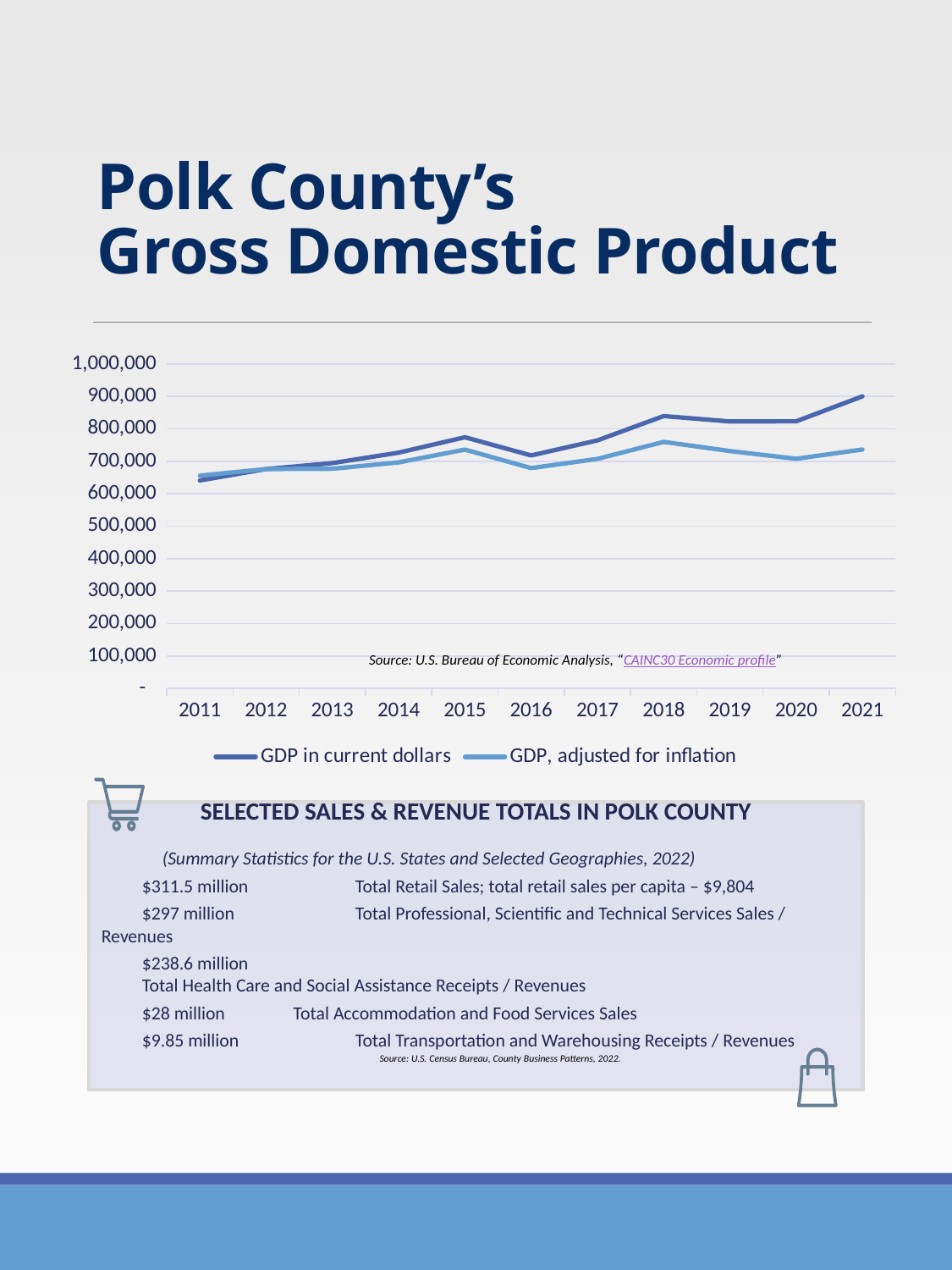
Is the value for GDP, adjusted for inflation in 2020 greater or less than 800,000? less Which year has the lowest value for GDP in current dollars? 2011 Which year has the highest value for GDP, adjusted for inflation? 2018 In 2021, which series has the larger value: GDP in current dollars or GDP, adjusted for inflation? GDP in current dollars Is the value for GDP in current dollars in 2011 greater or less than 700,000? less Which year has the highest value for GDP in current dollars? 2021 Is the value for GDP in current dollars in 2021 greater or less than 800,000? greater Overall, does GDP in current dollars rise or fall from 2011 to 2021? rise What kind of chart is shown on the slide? line chart How many years are plotted along the x axis of the chart? 11 What are the two series named in the chart's legend? GDP in current dollars; GDP, adjusted for inflation How many series does the chart's legend list? 2